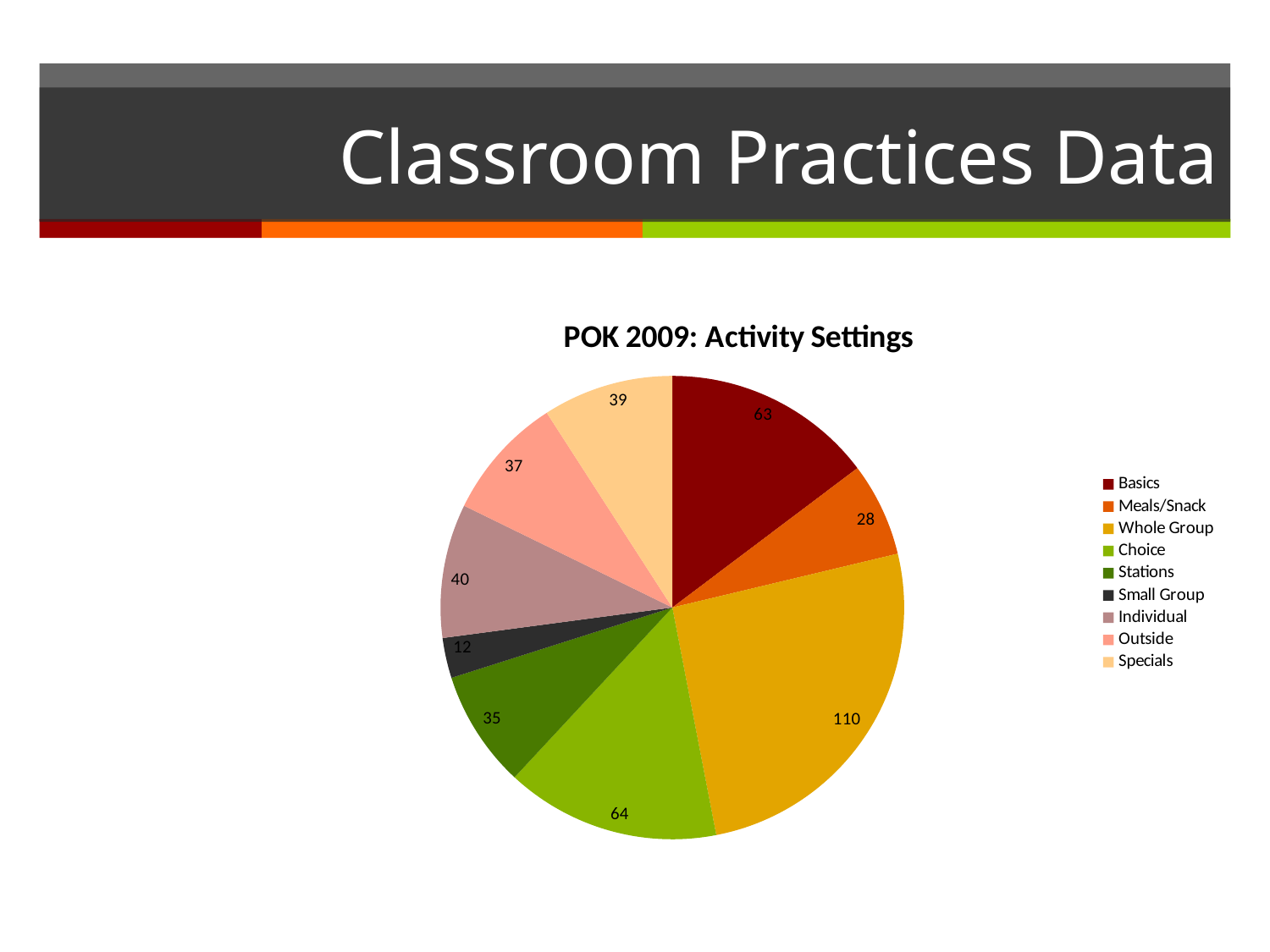
Which category has the smallest slice? Small Group What is the title of the chart? POK 2009: Activity Settings What is the value for Individual? 40 What type of chart is shown on the slide? pie chart What is the difference between the values for Whole Group and Choice? 46 What is the value for Small Group? 12 How many categories does the legend list? 9 Which category has the largest slice? Whole Group What is the total of all the slices in the pie? 428 Which is larger, the value for Stations or the value for Outside? Outside What is the value for Whole Group? 110 What is the value for Meals/Snack? 28